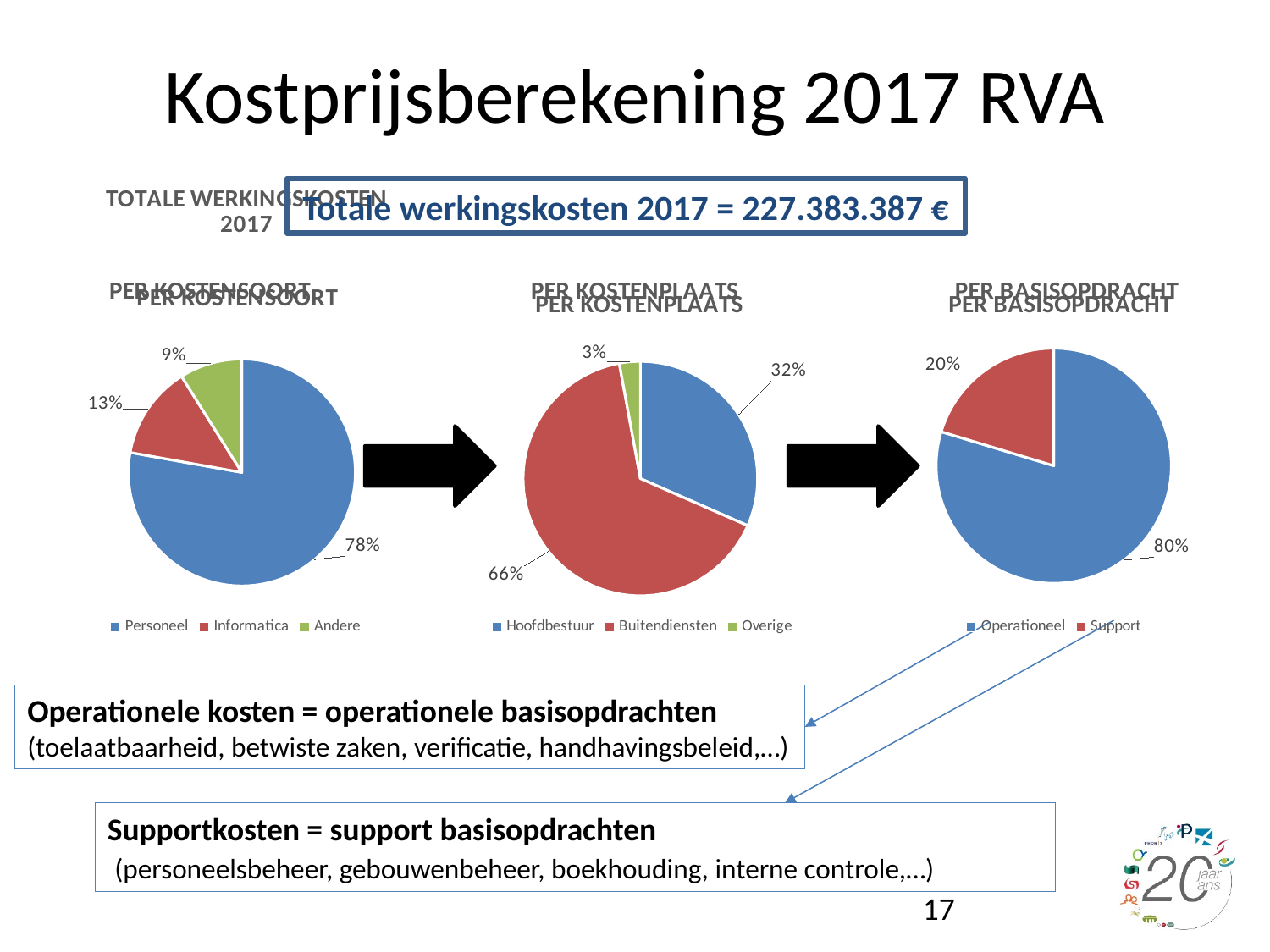
In the PER BASISOPDRACHT chart, what share does Support have? 20% In the PER KOSTENPLAATS chart, what share does Overige have? 3% How many categories does the legend of the PER BASISOPDRACHT chart list? 2 In the PER KOSTENSOORT chart, what share does Personeel have? 78% In the PER KOSTENPLAATS chart, what share does Buitendiensten have? 66% In the PER KOSTENPLAATS chart, which category has the largest share? Buitendiensten In the PER KOSTENSOORT chart, what share does Informatica have? 13% In the PER KOSTENPLAATS chart, which is larger, Hoofdbestuur or Buitendiensten? Buitendiensten In the PER BASISOPDRACHT chart, what is the difference between the Operationeel and Support shares? 60% What type of chart is the PER KOSTENSOORT chart? Pie chart In the PER KOSTENSOORT chart, what is the difference between the Personeel and Informatica shares? 65% In the PER KOSTENSOORT chart, which category has the smallest share? Andere